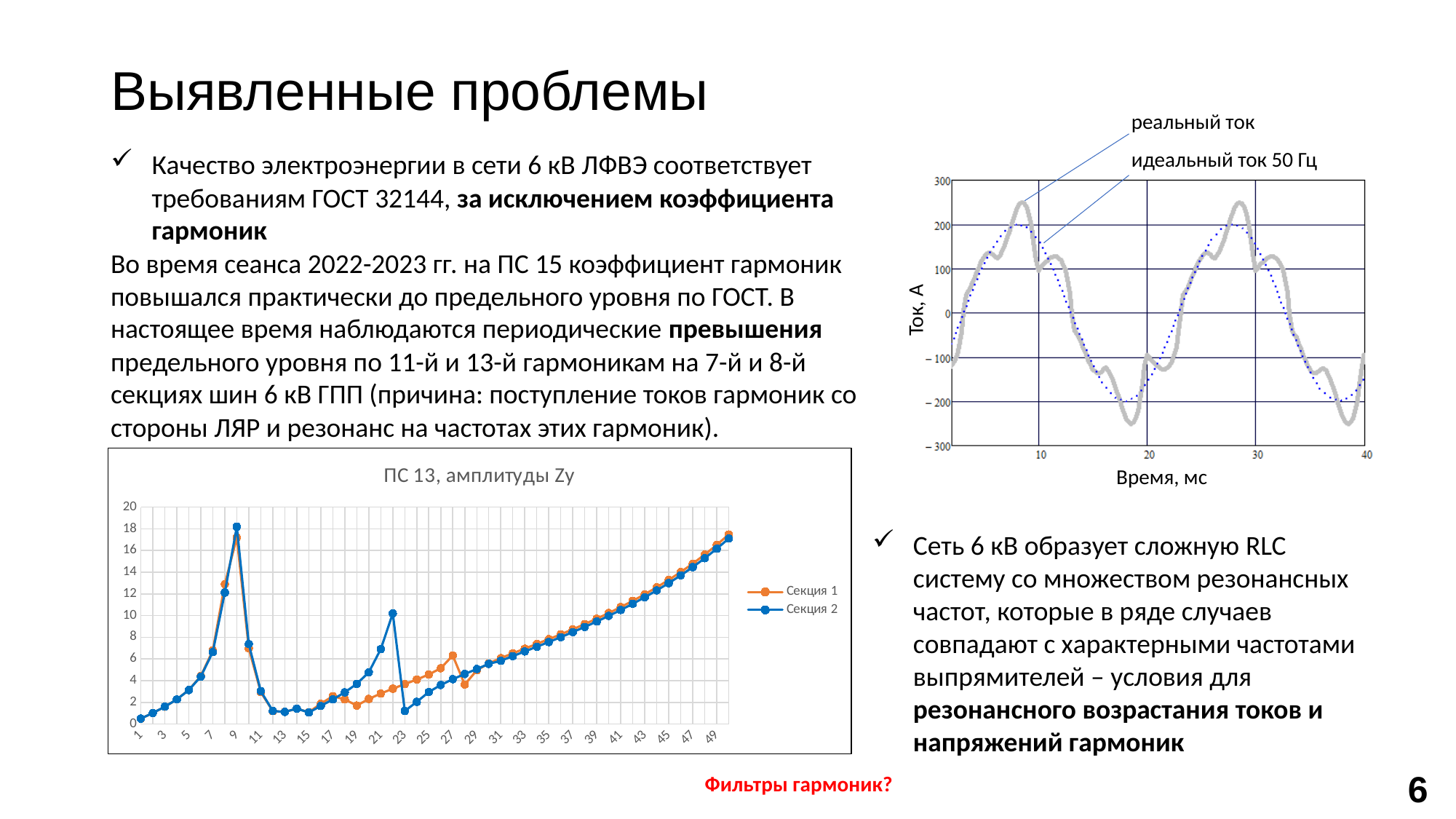
In the chart "ПС 13, амплитуды Zy", which series has the larger value at x = 22, Секция 1 or Секция 2? Секция 2 How many series does the legend of the chart "ПС 13, амплитуды Zy" list? 2 In the chart "ПС 13, амплитуды Zy", is the value of Секция 2 at x = 9 greater or less than 15? greater What are the legend entries of the chart "ПС 13, амплитуды Zy"? Секция 1, Секция 2 What kind of chart is the chart titled "ПС 13, амплитуды Zy"? line chart In the chart "ПС 13, амплитуды Zy", is the value of Секция 2 at x = 23 greater or less than 2? less In the chart "ПС 13, амплитуды Zy", is the value of Секция 1 at x = 49 greater or less than 15? greater In the chart "ПС 13, амплитуды Zy", which series has the larger value at x = 27, Секция 1 or Секция 2? Секция 1 In the current waveform chart at the top right, what is the label of the vertical axis? Ток, А In the chart "ПС 13, амплитуды Zy", do the values of Секция 1 rise or fall from x = 31 to x = 49? rise